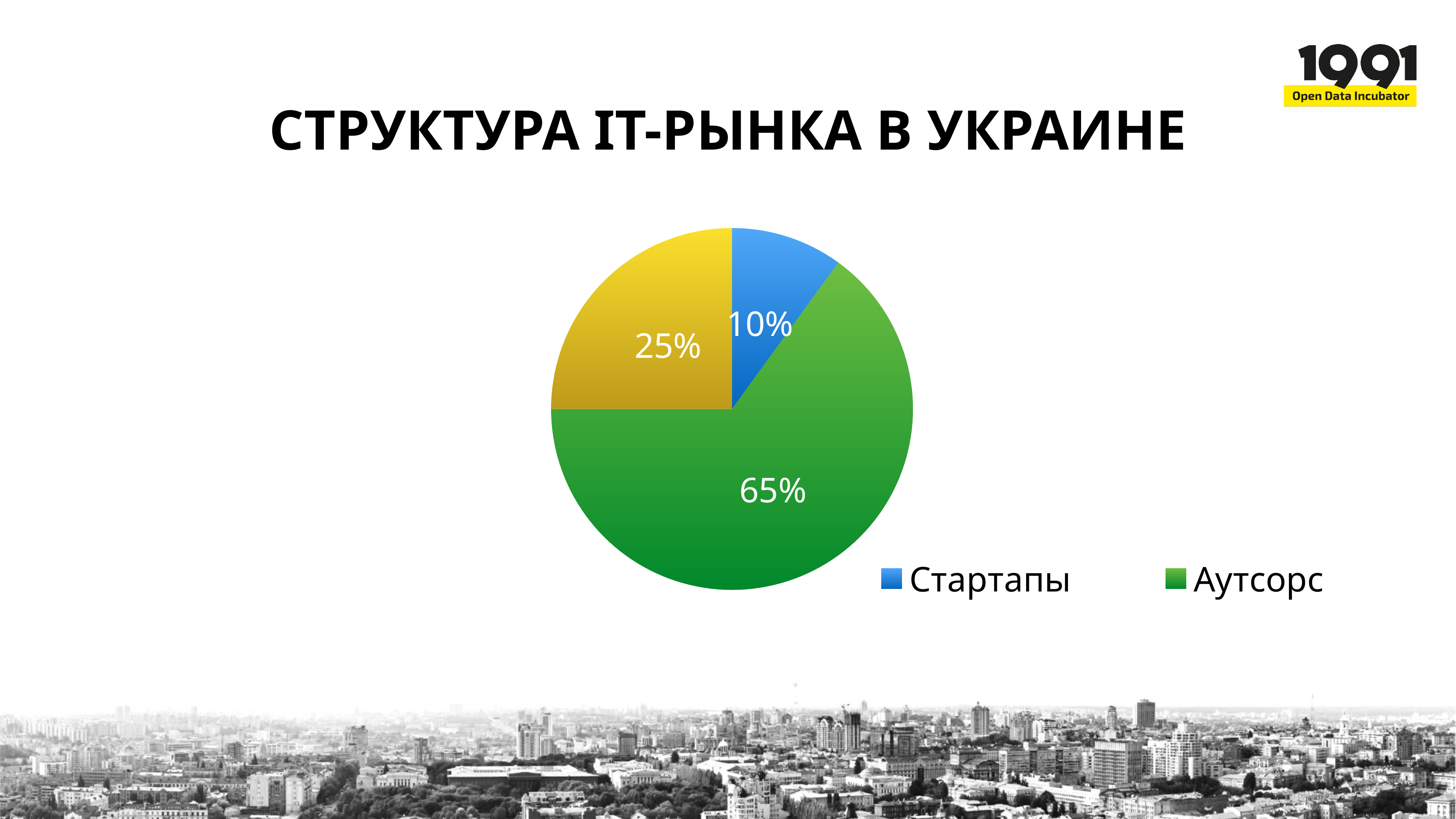
Which category has the largest slice of the pie? Аутсорс What is the title of the slide containing the pie chart? СТРУКТУРА IT-РЫНКА В УКРАИНЕ Which category has the smallest slice of the pie? Стартапы What is the difference in percentage points between Аутсорс and Стартапы? 55 What percentage is printed on the yellow slice of the pie? 25% What share of the pie does Стартапы have? 10% What share of the pie does Аутсорс have? 65% How many entries does the legend list? 2 How many slices does the pie chart have? 3 Which is larger, the share for Стартапы or the share for Аутсорс? Аутсорс What kind of chart is shown on the slide? pie chart What colour is the slice for Аутсорс? green